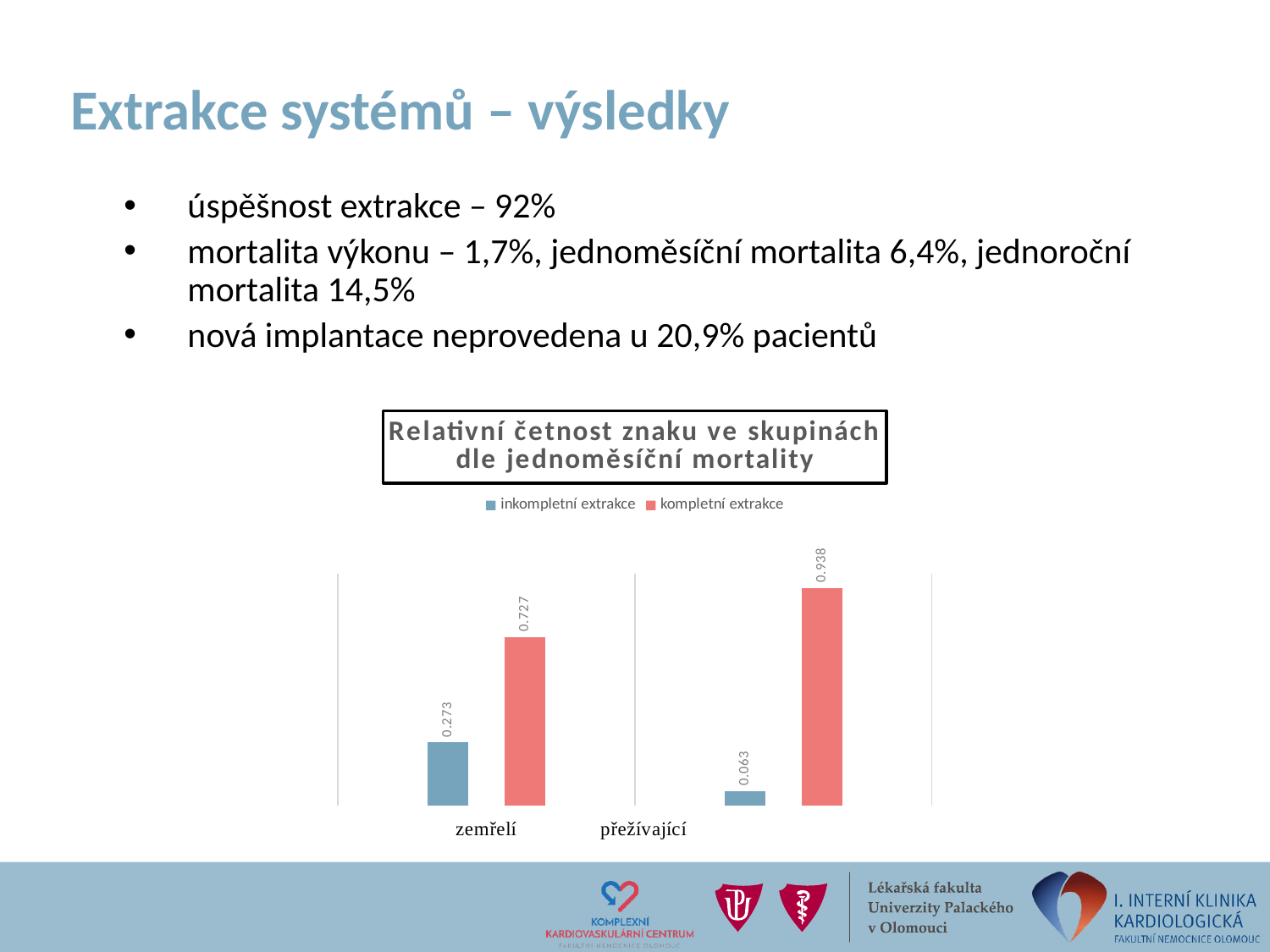
What is the value for kompletní extrakce in the přežívající group? 0.938 What is the value for kompletní extrakce in the zemřelí group? 0.727 What is the value for inkompletní extrakce in the přežívající group? 0.063 How many series does the chart legend list? 2 Which is larger: inkompletní extrakce for zemřelí or inkompletní extrakce for přežívající? zemřelí Which bar in the chart has the highest value? kompletní extrakce, přežívající What is the difference between kompletní extrakce and inkompletní extrakce in the přežívající group? 0.875 What is the difference between kompletní extrakce and inkompletní extrakce in the zemřelí group? 0.454 What kind of chart is shown on the slide? bar chart What is the title of the chart? Relativní četnost znaku ve skupinách dle jednoměsíční mortality Which bar in the chart has the lowest value? inkompletní extrakce, přežívající What is the value for inkompletní extrakce in the zemřelí group? 0.273